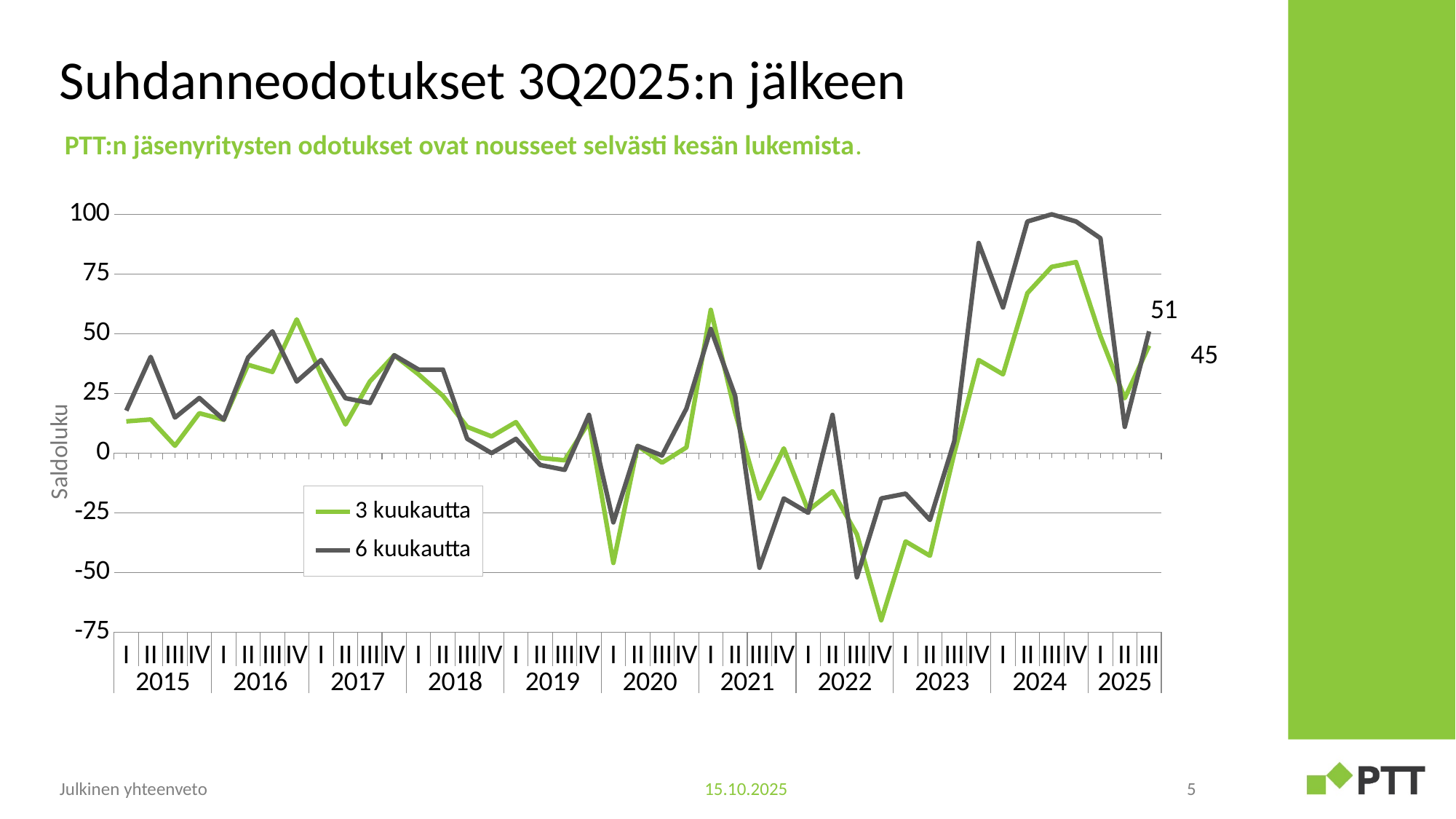
What is the title of the vertical axis? Saldoluku What is the value of the 6 kuukautta series at the last point (2025 III)? 51 At the last point (2025 III), which series has the higher value, 3 kuukautta or 6 kuukautta? 6 kuukautta In which year does the 3 kuukautta series reach its lowest point? 2022 Is the value of the 6 kuukautta series in 2024 II greater or less than 75? greater Which series reaches the highest peak on the chart? 6 kuukautta What is the difference between the 6 kuukautta and 3 kuukautta values at the last point (2025 III)? 6 How many series does the legend list? 2 Is the value of the 3 kuukautta series in 2022 IV greater or less than -50? less Does the 6 kuukautta series rise or fall from 2025 II to 2025 III? rise What kind of chart is shown on the slide? line chart What is the value of the 3 kuukautta series at the last point (2025 III)? 45